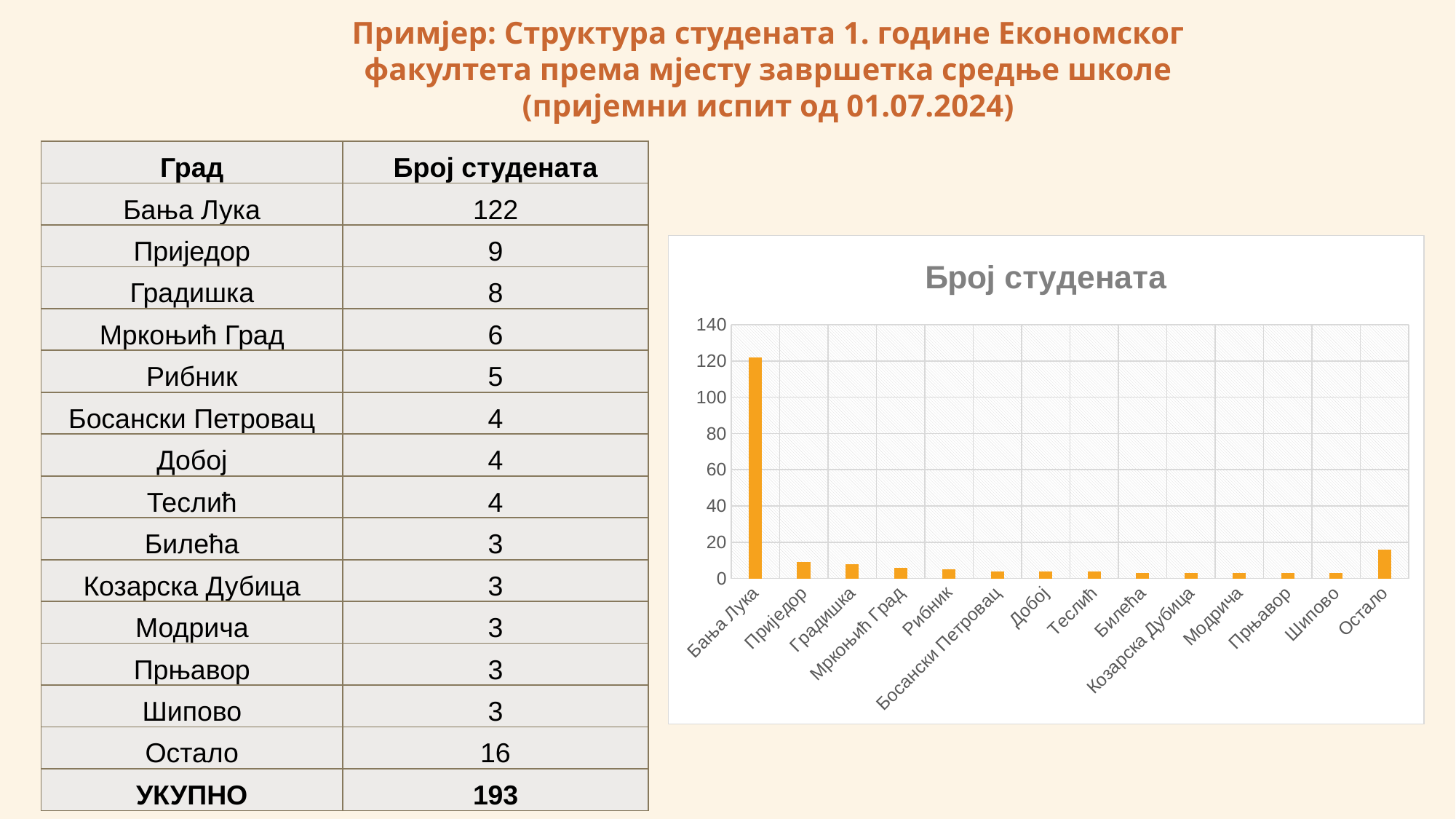
What kind of chart is shown on the slide? bar chart Is the value for Бања Лука greater or less than 100? greater What is the difference between the values for Приједор and Градишка? 1 What is the value for Приједор? 9 Which is larger, the value for Остало or the value for Приједор? Остало Which category has the highest value in the chart? Бања Лука Is the value for Остало greater or less than 20? less What is the value for Бања Лука? 122 What is the title of the chart? Број студената How many categories (cities) are plotted on the x axis of the chart? 14 What is the difference between the values for Бања Лука and Остало? 106 What is the value for Остало? 16